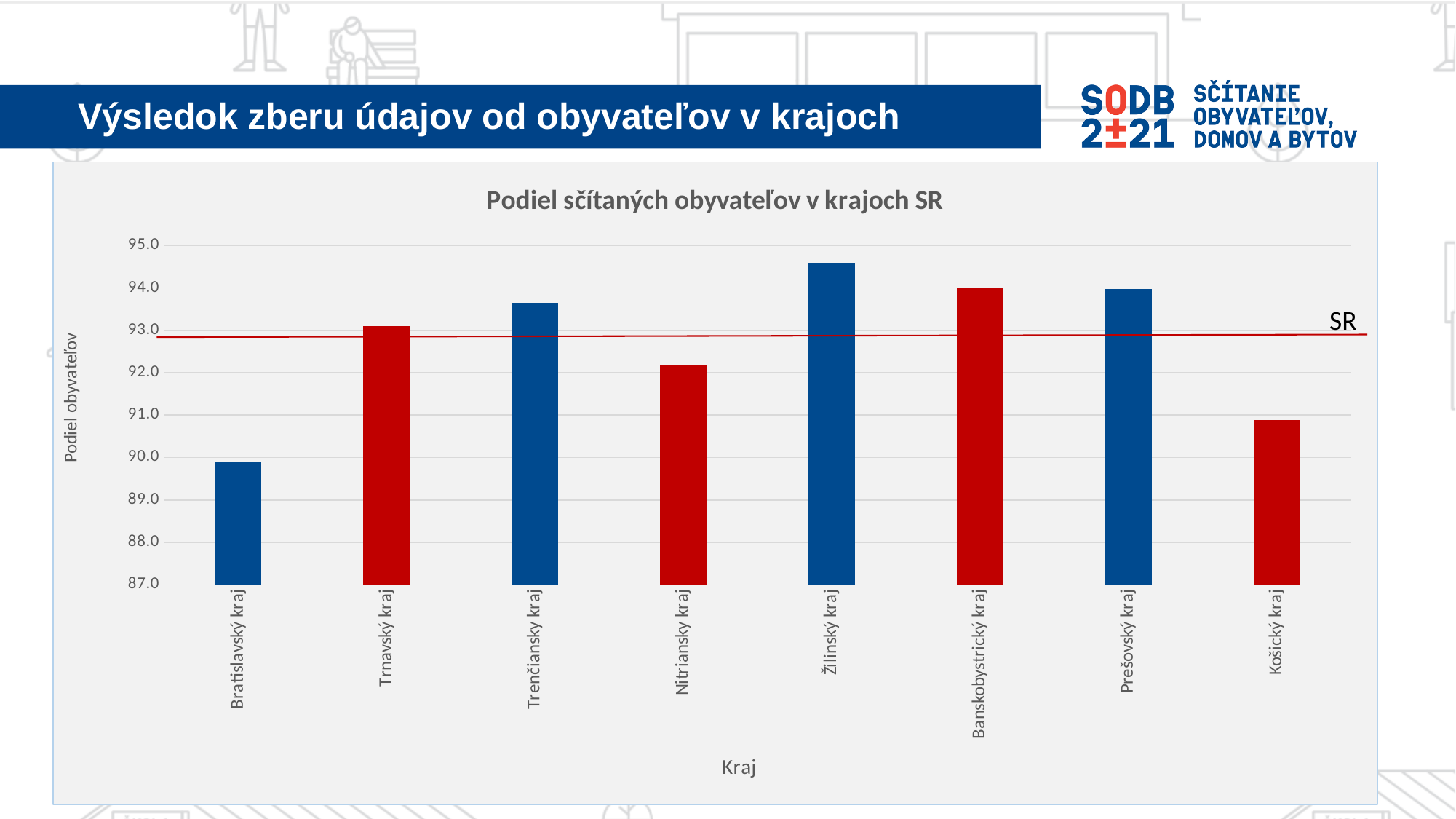
Is the value for Bratislavský kraj greater or less than 91.0? less Is the value for Trenčiansky kraj greater or less than 93.0? greater Which has a higher value, Trenčiansky kraj or Trnavský kraj? Trenčiansky kraj What is the title of the chart? Podiel sčítaných obyvateľov v krajoch SR Which has a higher value, Nitriansky kraj or Košický kraj? Nitriansky kraj How many regions (kraje) are shown on the x axis of the chart? 8 Which region has the lowest share of counted inhabitants in the chart? Bratislavský kraj Is the value for Žilinský kraj greater or less than 94.0? greater What label is attached to the horizontal red reference line in the chart? SR What type of chart is shown on the slide? bar chart Which region has the highest share of counted inhabitants in the chart? Žilinský kraj